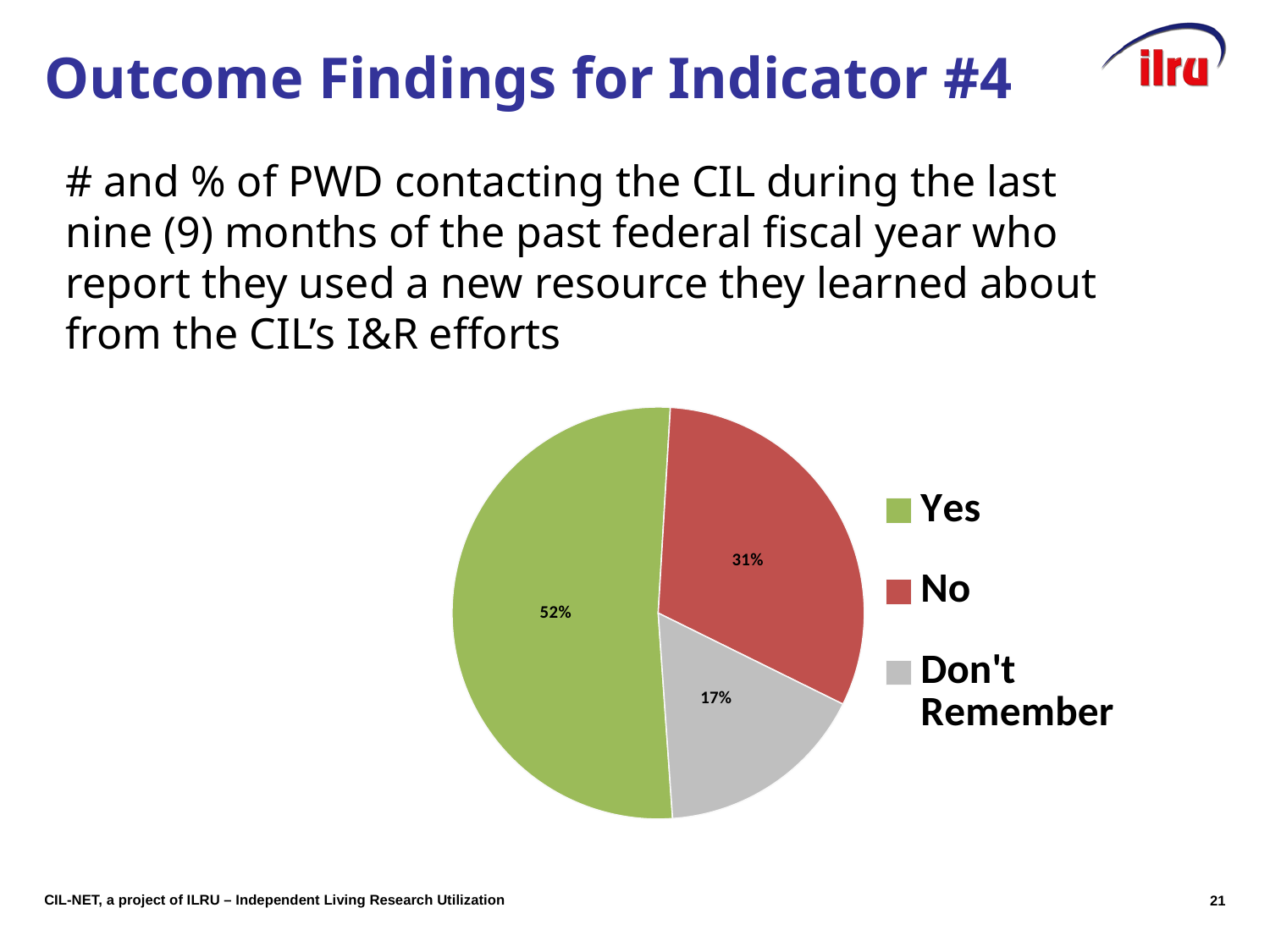
What percentage of the pie chart is the "Don't Remember" slice? 17% What kind of chart is shown on the slide? Pie chart What colour is the "No" slice in the pie chart? Red Which category has the smallest share of the pie chart? Don't Remember Which category has the largest share of the pie chart? Yes What is the difference in percentage points between the "No" and "Don't Remember" slices? 14 Which slice is larger, "No" or "Don't Remember"? No How many categories does the pie chart show? 3 What percentage of the pie chart is the "No" slice? 31% What percentage of the pie chart is the "Yes" slice? 52% What colour is the "Yes" slice in the pie chart? Green What is the difference in percentage points between the "Yes" and "No" slices? 21